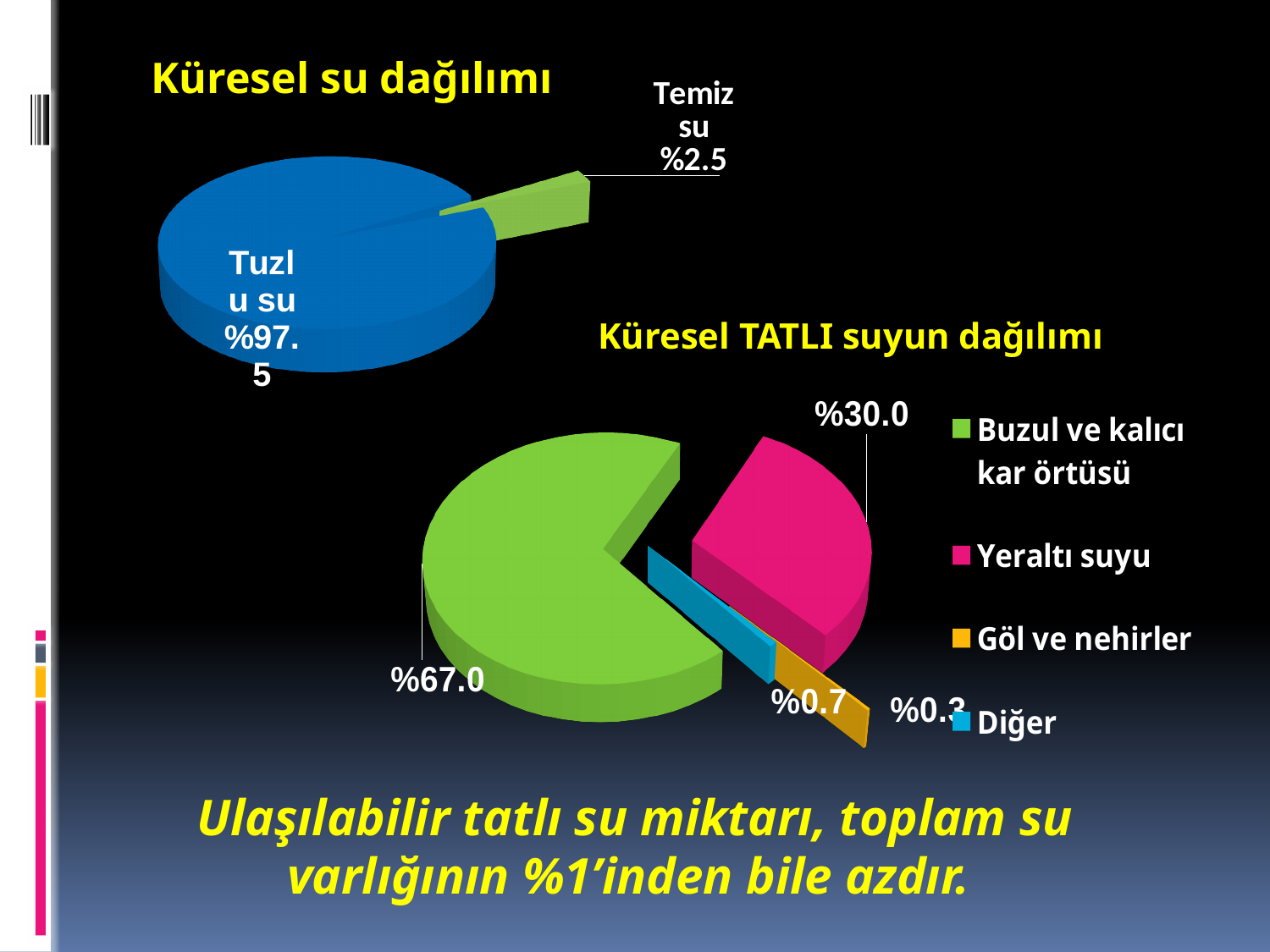
In the 'Küresel TATLI suyun dağılımı' chart, which category has the largest share? Buzul ve kalıcı kar örtüsü In the 'Küresel TATLI suyun dağılımı' chart, what is the value for Yeraltı suyu? %30.0 How many slices does the 'Küresel su dağılımı' pie chart have? 2 In the 'Küresel su dağılımı' chart, what is the value for Temiz su? %2.5 What kind of chart is the 'Küresel su dağılımı' chart? Pie chart In the 'Küresel TATLI suyun dağılımı' chart, what colour is the Yeraltı suyu slice? Pink In the 'Küresel su dağılımı' chart, what is the value for Tuzlu su? %97.5 In the 'Küresel su dağılımı' chart, what is the difference between Tuzlu su and Temiz su? %95.0 In the 'Küresel su dağılımı' chart, which is larger, Tuzlu su or Temiz su? Tuzlu su In the 'Küresel TATLI suyun dağılımı' chart, what is the difference between Buzul ve kalıcı kar örtüsü and Yeraltı suyu? %37.0 How many entries does the legend of the 'Küresel TATLI suyun dağılımı' chart list? 4 In the 'Küresel TATLI suyun dağılımı' chart, what is the value for Buzul ve kalıcı kar örtüsü? %67.0